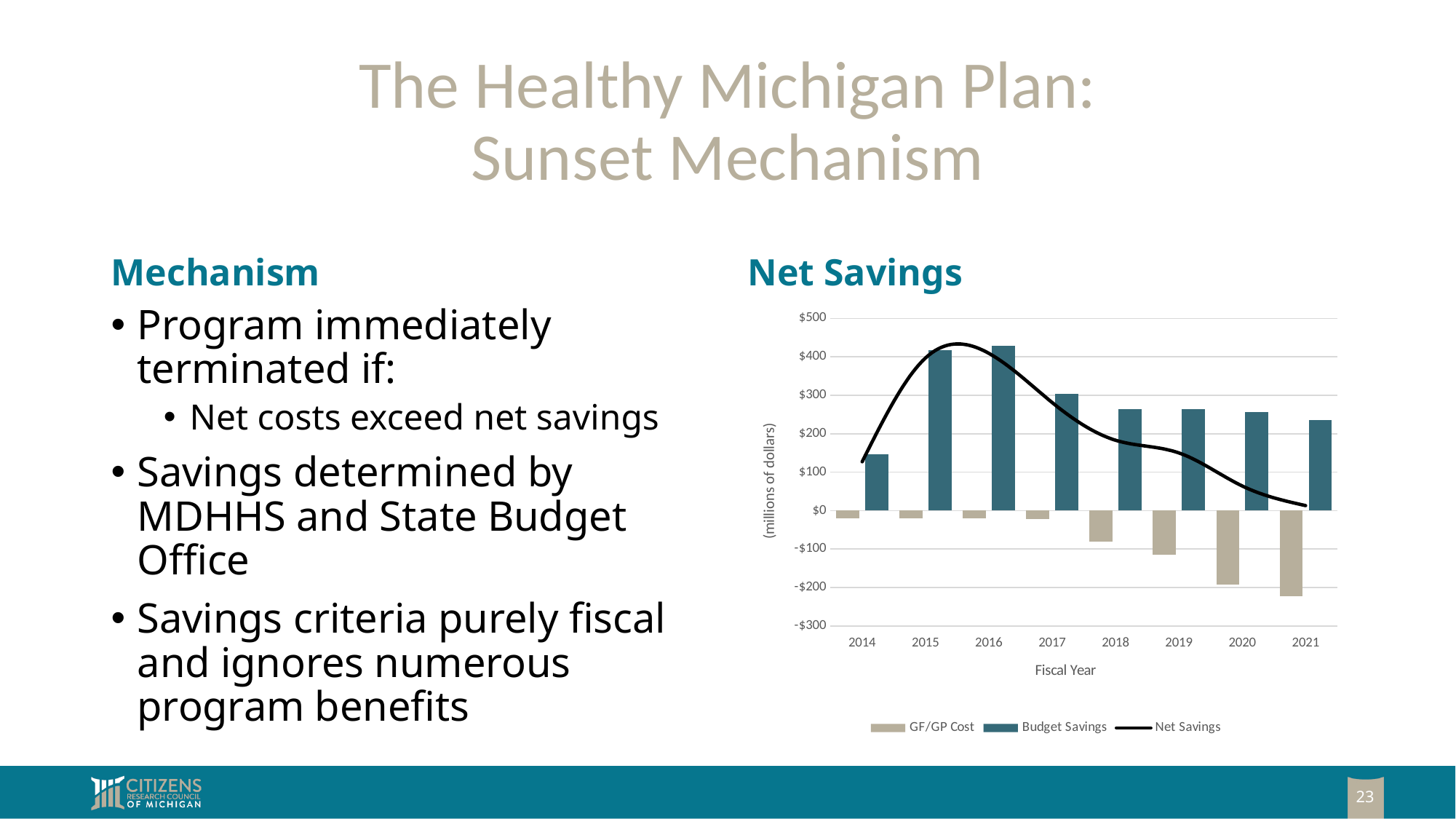
How many series does the legend of the Net Savings chart list? 3 In the Net Savings chart, is the Budget Savings value for 2016 greater or less than $400? greater In the Net Savings chart, is the Budget Savings value for 2014 greater or less than $200? less What is the label on the y axis of the Net Savings chart? (millions of dollars) In the Net Savings chart, does the Net Savings line rise or fall from 2016 to 2021? fall In the Net Savings chart, which fiscal year has the largest (most negative) GF/GP Cost bar? 2021 In the Net Savings chart, which is larger: the Budget Savings bar for 2015 or for 2017? 2015 In the Net Savings chart, is the Net Savings line value for 2021 greater or less than $100? less How many fiscal years are shown on the x axis of the Net Savings chart? 8 In the Net Savings chart, which fiscal year has the lowest Budget Savings bar? 2014 What type of chart is shown under the heading "Net Savings"? bar chart with a line